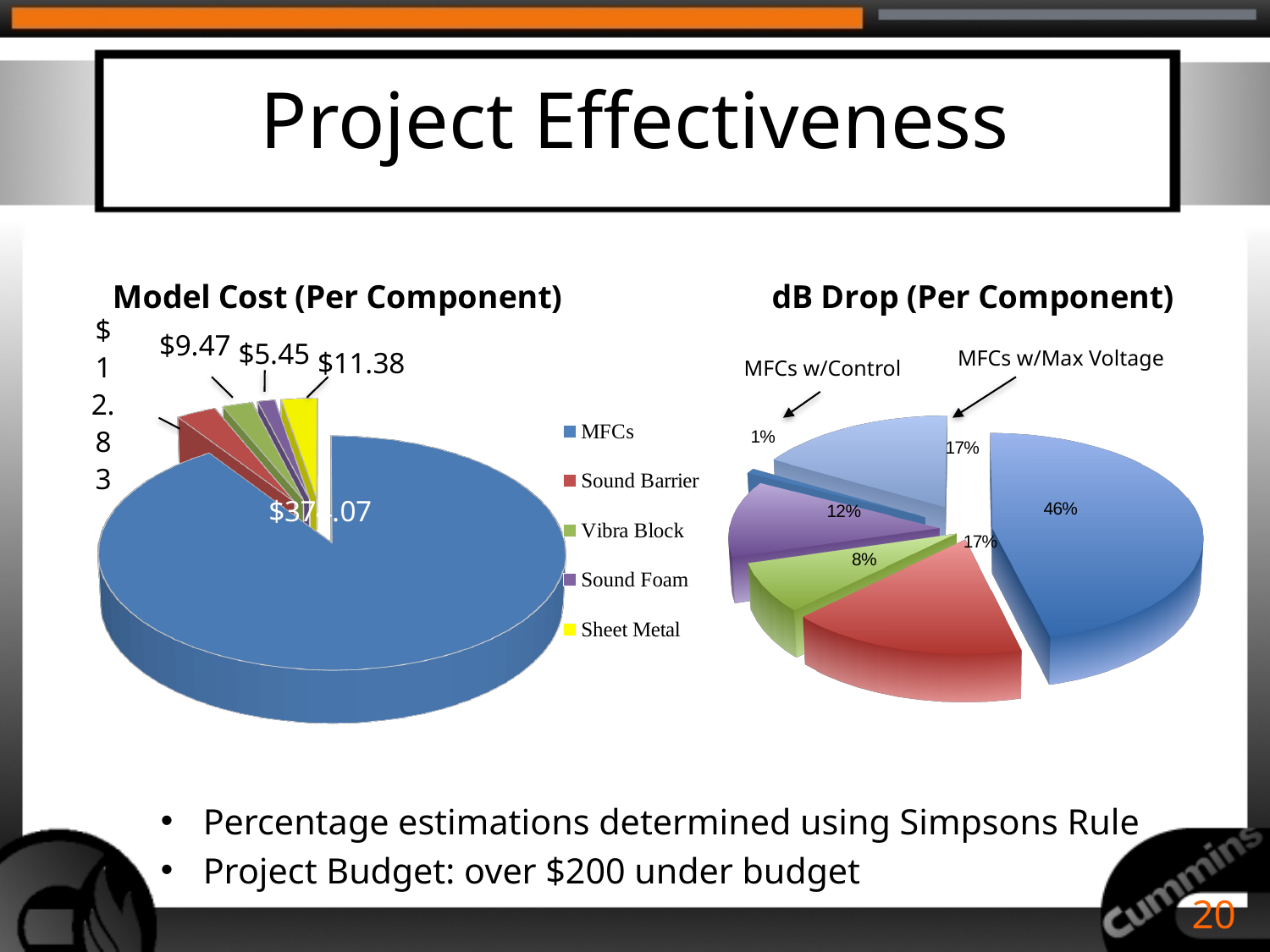
How many slices does the "dB Drop (Per Component)" pie chart have? 6 In the "dB Drop (Per Component)" chart, what is the percentage of the largest slice? 46% In the "Model Cost (Per Component)" chart, which component has the largest slice? MFCs How many categories does the legend of the "Model Cost (Per Component)" chart list? 5 In the "Model Cost (Per Component)" chart, what is the cost shown for Vibra Block? $9.47 In the "Model Cost (Per Component)" chart, which is larger, the cost for Sheet Metal or for Sound Foam? Sheet Metal In the "Model Cost (Per Component)" chart, what is the difference between the Sheet Metal cost and the Sound Foam cost? $5.93 In the "dB Drop (Per Component)" chart, what share is shown for MFCs w/Control? 1% In the "dB Drop (Per Component)" chart, what share is shown for MFCs w/Max Voltage? 17% What kind of chart is the "Model Cost (Per Component)" chart on the left? Pie chart In the "Model Cost (Per Component)" chart, what is the cost shown for Sound Foam? $5.45 In the "Model Cost (Per Component)" chart, what is the cost shown for Sheet Metal? $11.38